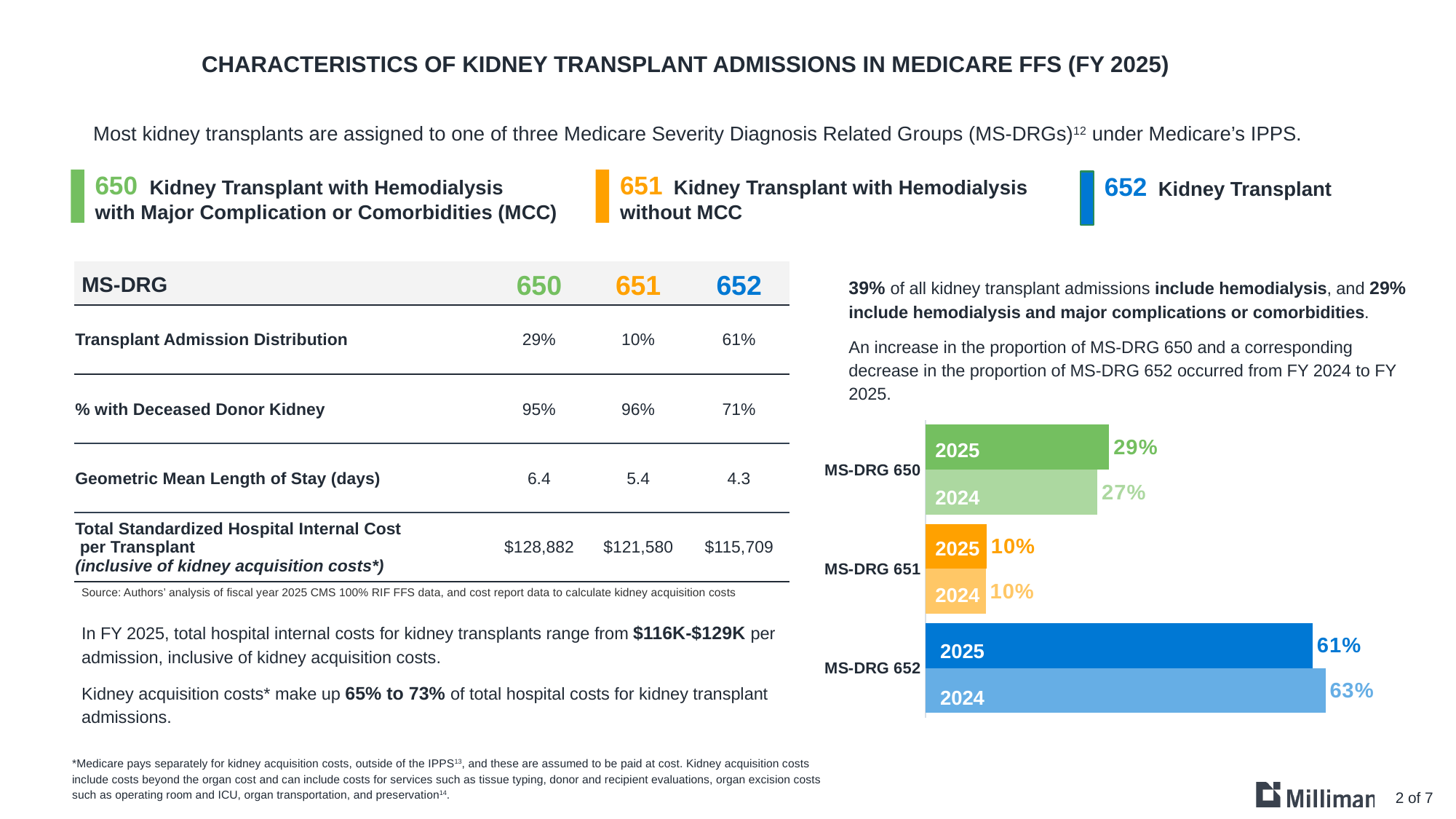
In the bar chart, what is the 2024 value for MS-DRG 650? 27% In the bar chart, which MS-DRG has the highest 2025 value? MS-DRG 652 In the bar chart, what is the difference between the 2025 and 2024 values for MS-DRG 650? 2% In the bar chart, what is the 2025 value for MS-DRG 650? 29% In the bar chart, what is the 2024 value for MS-DRG 651? 10% In the bar chart, what is the 2024 value for MS-DRG 652? 63% In the bar chart, is the 2025 value for MS-DRG 650 larger or smaller than its 2024 value? larger How many MS-DRG categories are shown in the bar chart? 3 In the bar chart, which MS-DRG has the lowest 2025 value? MS-DRG 651 In the bar chart, is the 2025 value for MS-DRG 652 larger or smaller than its 2024 value? smaller In the bar chart, what is the difference between the 2024 and 2025 values for MS-DRG 652? 2% What type of chart is shown on the right side of the slide? bar chart